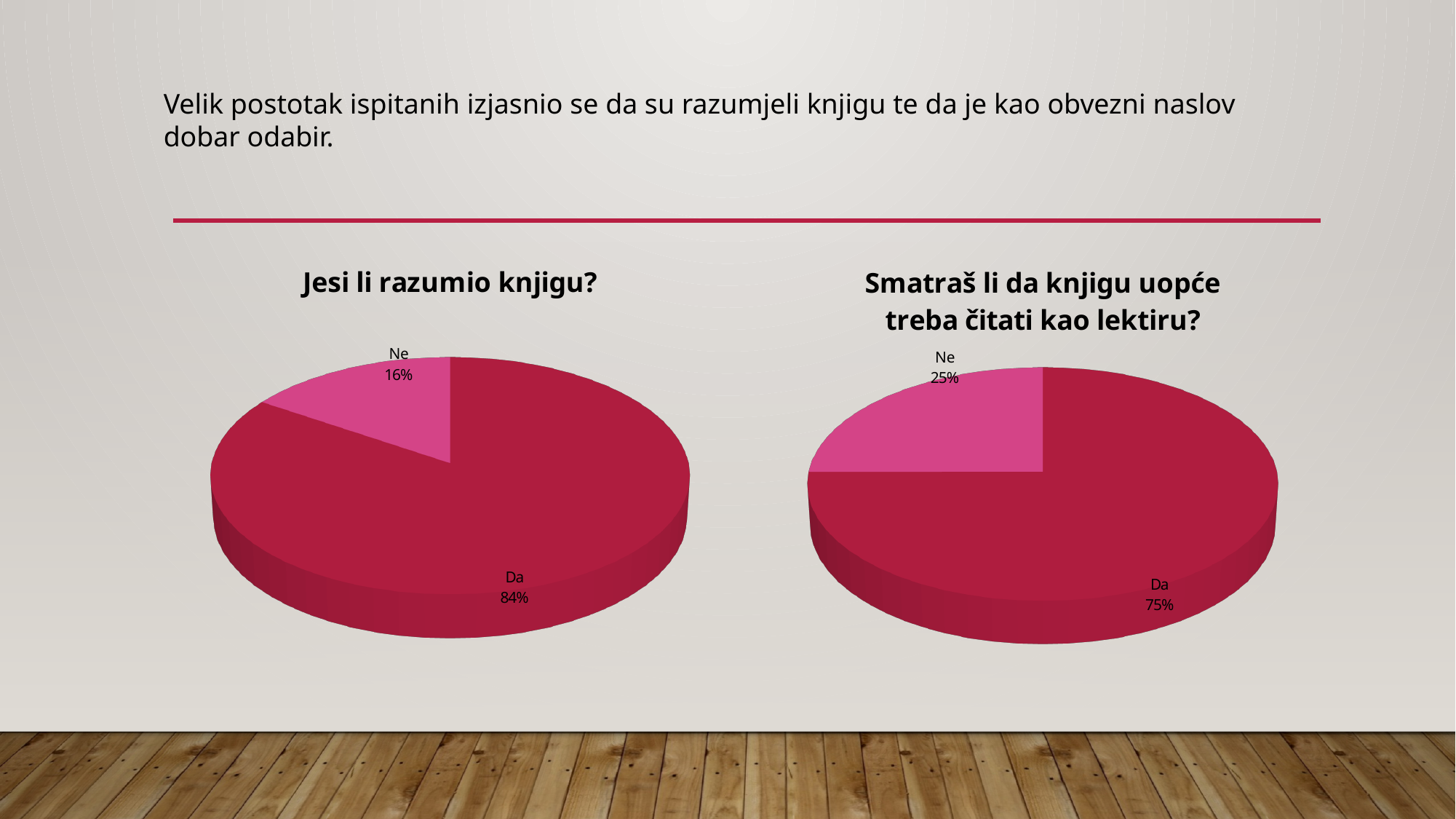
In the right chart, which answer has the smallest share? Ne What is the title of the chart on the right side of the slide? Smatraš li da knjigu uopće treba čitati kao lektiru? How many slices does the chart titled "Jesi li razumio knjigu?" have? 2 In the chart titled "Jesi li razumio knjigu?", what percentage answered "Da"? 84% In the chart titled "Smatraš li da knjigu uopće treba čitati kao lektiru?", what is the difference in percentage points between "Da" and "Ne"? 50 In the chart titled "Smatraš li da knjigu uopće treba čitati kao lektiru?", what percentage answered "Da"? 75% In the chart titled "Smatraš li da knjigu uopće treba čitati kao lektiru?", what percentage answered "Ne"? 25% In the chart titled "Jesi li razumio knjigu?", what percentage answered "Ne"? 16% What type of chart is used on the left side of the slide? pie chart In the left chart, which answer has the largest share? Da Which chart has the larger "Ne" share, the left chart or the right chart? the right chart In the chart titled "Jesi li razumio knjigu?", what is the difference in percentage points between "Da" and "Ne"? 68